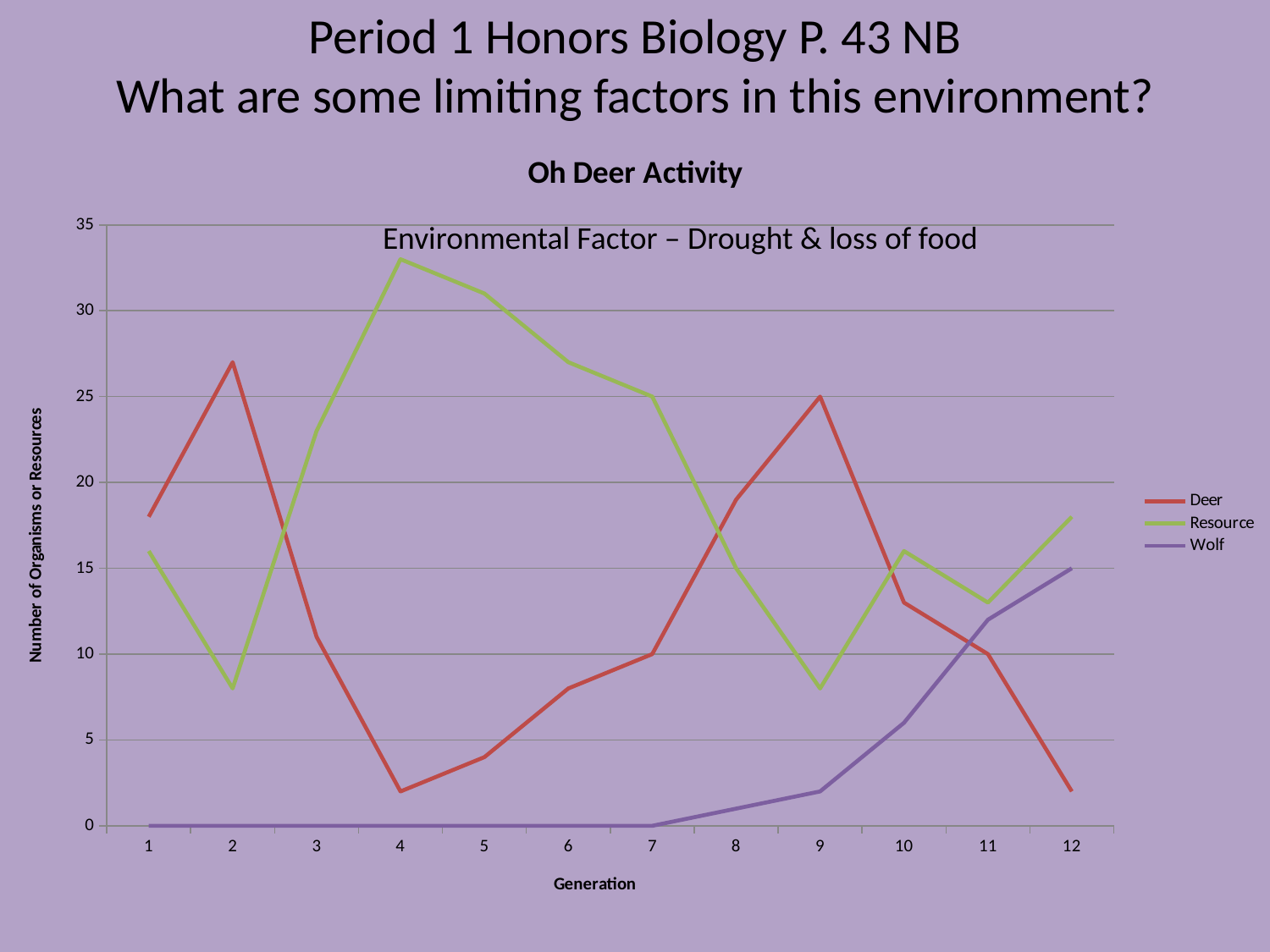
What kind of chart is shown on the slide? Line chart At generation 4, which is larger, the Deer value or the Resource value? Resource How many generations are plotted along the x axis? 12 Is the Resource value at generation 4 greater or less than 30? greater Is the Deer value at generation 4 greater or less than 5? less What is the Deer value at generation 7? 10 Does the Wolf series rise or fall from generation 7 to generation 12? Rise What is the Wolf value at generation 1? 0 At which generation does the Resource series reach its highest value? 4 What is the Deer value at generation 9? 25 At which generation does the Deer series reach its highest value? 2 How many series does the legend list? 3